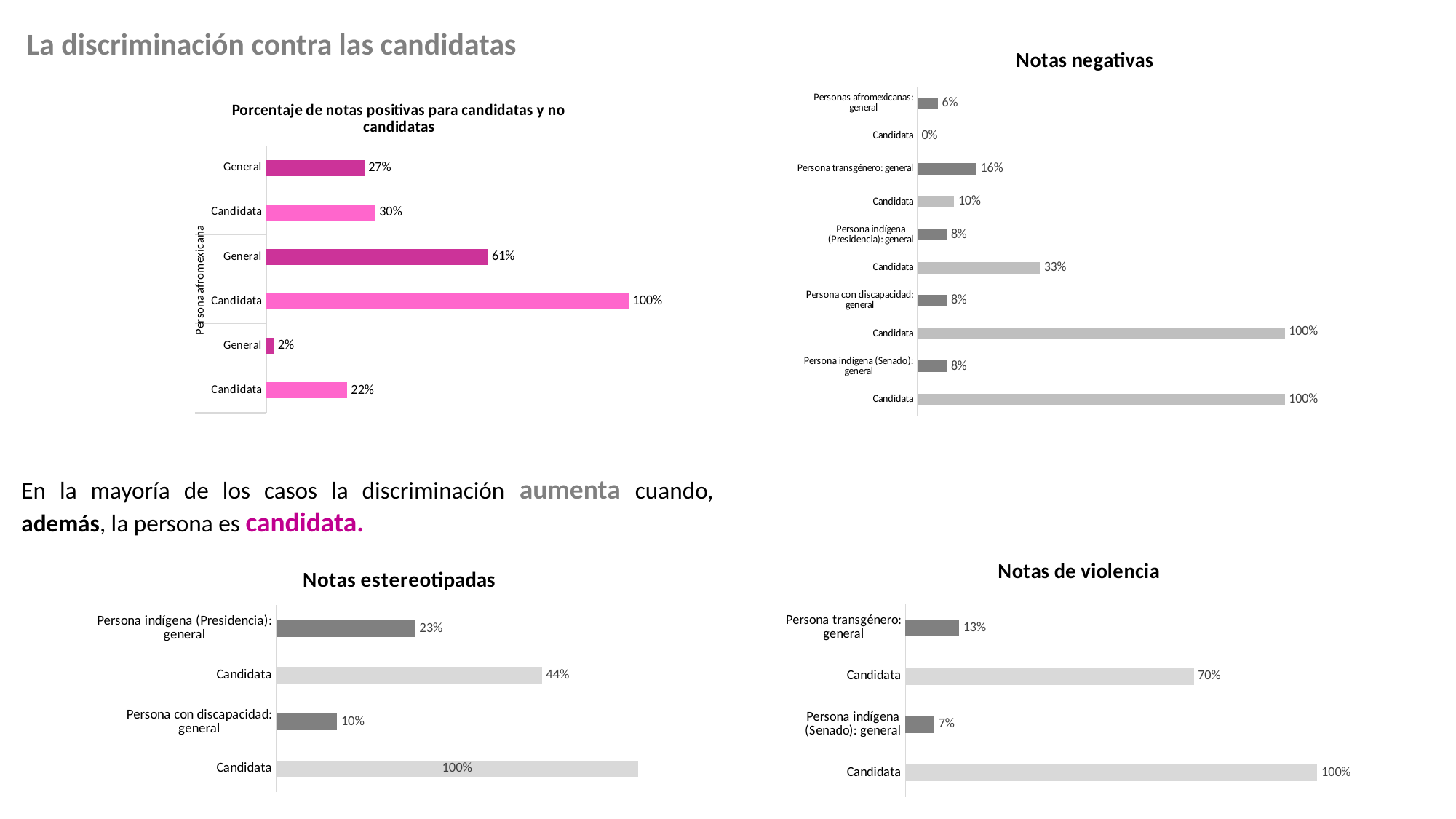
In the 'Notas negativas' chart, what is the value for the 'Candidata' bar directly below 'Persona indígena (Presidencia): general'? 33% In the 'Notas estereotipadas' chart, what is the value for 'Persona indígena (Presidencia): general'? 23% In the 'Notas negativas' chart, what is the value for 'Persona transgénero: general'? 16% In the 'Notas estereotipadas' chart, which category has the lowest value? Persona con discapacidad: general In the 'Notas de violencia' chart, which is larger: 'Persona transgénero: general' or 'Persona indígena (Senado): general'? Persona transgénero: general In the 'Notas de violencia' chart, how many bars are plotted? 4 In the 'Notas negativas' chart, what is the value for 'Personas afromexicanas: general'? 6% In the 'Notas de violencia' chart, what is the value for the 'Candidata' bar directly below 'Persona transgénero: general'? 70% What kind of chart is 'Notas estereotipadas'? Bar chart In the 'Notas negativas' chart, how many bars are plotted? 10 In the chart titled 'Porcentaje de notas positivas para candidatas y no candidatas', what is the value of the topmost 'General' bar? 27% In the 'Notas estereotipadas' chart, what is the difference between the 'Candidata' bar below 'Persona indígena (Presidencia): general' (44%) and that general bar (23%)? 21%